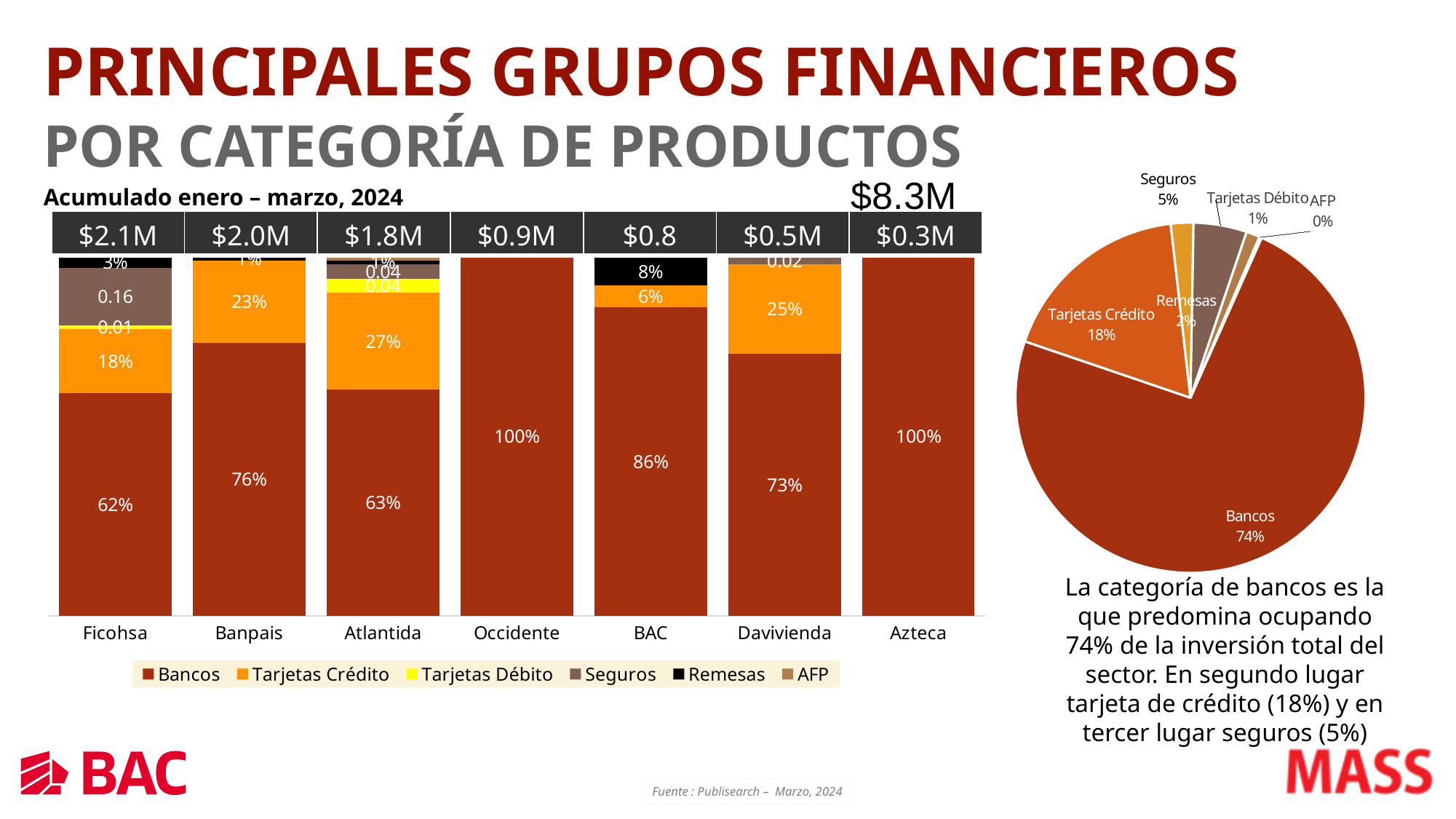
In the pie chart, which category has the smallest slice? AFP In the stacked bar chart, what is the Remesas share for BAC? 8% What kind of chart is the one on the left of the slide? Stacked bar chart In the stacked bar chart, which has the larger Tarjetas Crédito share, Davivienda or Banpais? Davivienda In the stacked bar chart, what is the Tarjetas Crédito share for Atlantida? 27% In the pie chart, what share of the total does Bancos represent? 74% In the stacked bar chart, which group has the highest Tarjetas Crédito share? Atlantida In the stacked bar chart, what is the difference in percentage points between the Bancos share of Banpais and that of Ficohsa? 14 percentage points How many product categories does the legend of the stacked bar chart list? 6 How many financial groups are shown on the x axis of the stacked bar chart? 7 In the stacked bar chart, what percentage of Ficohsa's investment goes to Bancos? 62% In the stacked bar chart, what total amount is shown above the Ficohsa bar? $2.1M